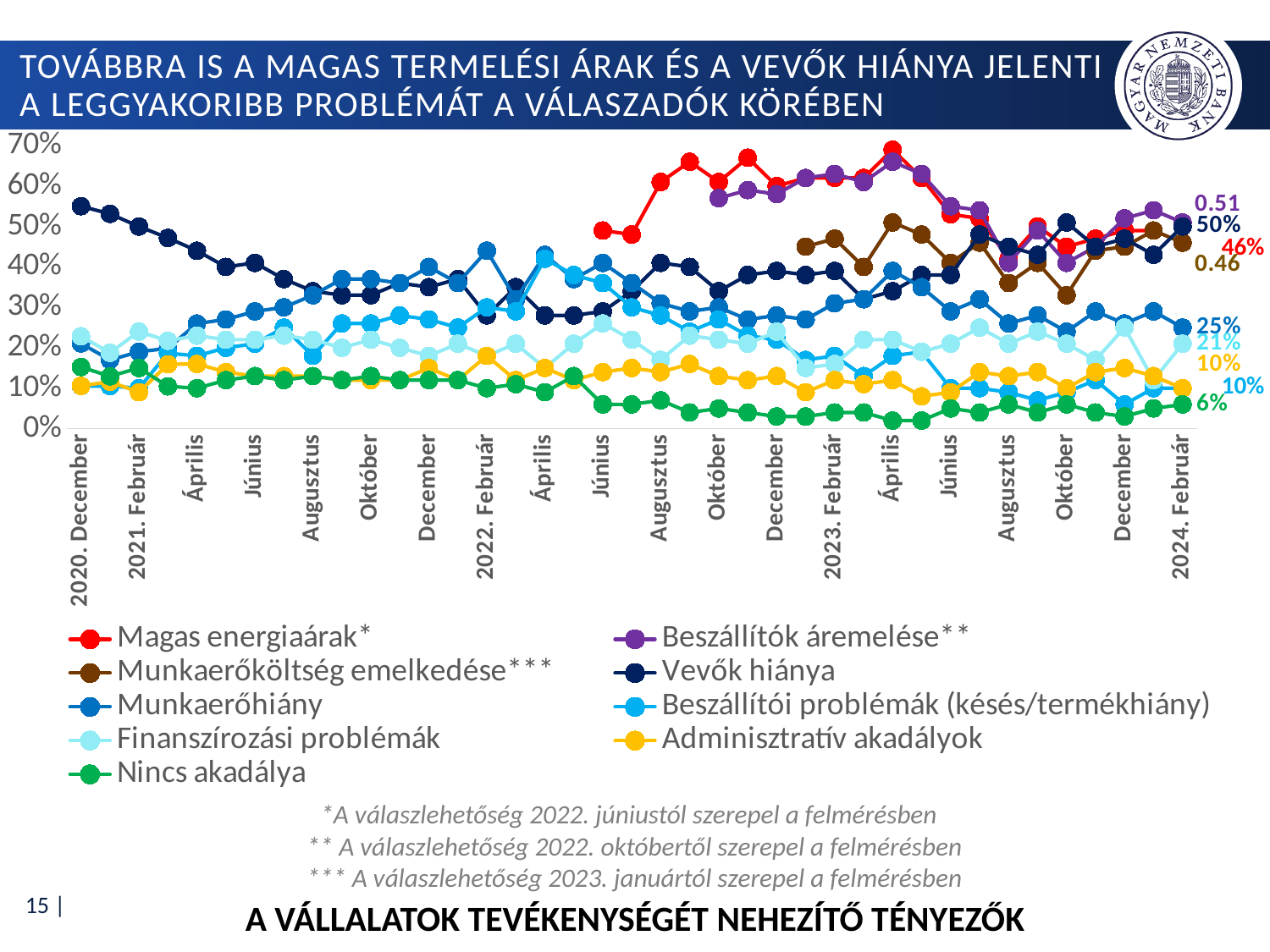
What is the difference between Vevők hiánya and Munkaerőhiány in 2024. Február? 25 percentage points How many series does the legend list? 9 What is the value for Nincs akadálya in 2024. Február? 6% Which series has the lowest value in 2024. Február? Nincs akadálya Does the Vevők hiánya series rise or fall from 2020. December to 2022. Február? fall What is the value for Munkaerőhiány in 2024. Február? 25% Is the value for Vevők hiánya in 2020. December greater or less than 50%? greater What type of chart is shown on the slide? line chart What is the value for Vevők hiánya in 2024. Február? 50% Which series has the highest value in 2024. Február? Beszállítók áremelése